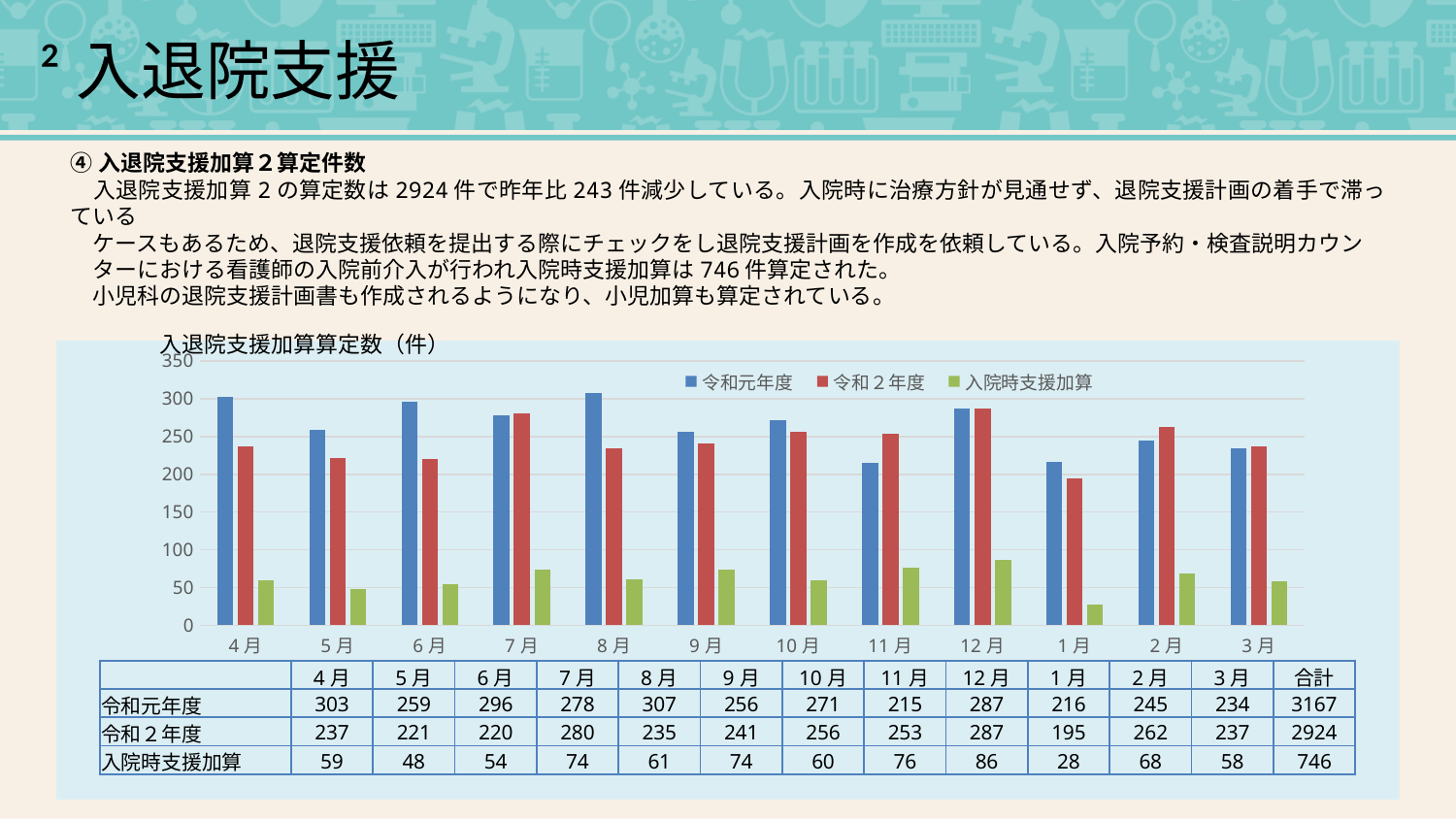
How many months are shown on the x axis of the chart? 12 What is the value for 入院時支援加算 in 12月? 86 What is the value for 令和元年度 in 8月? 307 What is the difference between the 令和元年度 and 令和２年度 values in 4月? 66 In which month is the 入院時支援加算 value the lowest? 1月 What is the value for 令和２年度 in 7月? 280 What type of chart is shown on the slide? bar chart What is the title of the chart? 入退院支援加算算定数（件） Is the 令和２年度 value for 1月 greater or less than 200? less In which month is the 令和元年度 value the highest? 8月 How many series does the legend of the chart list? 3 Which is larger in 11月, the 令和元年度 value or the 令和２年度 value? 令和２年度